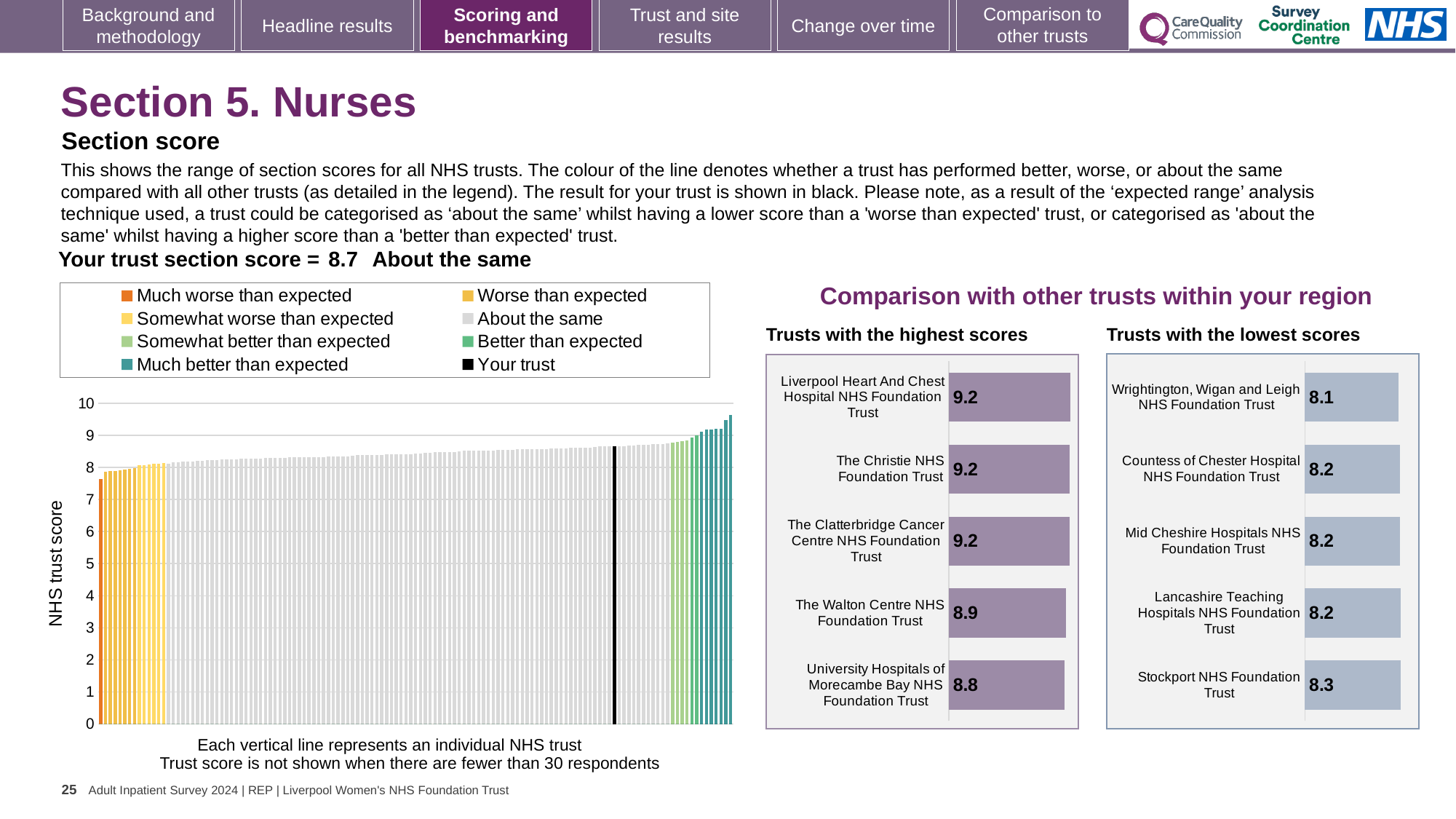
On the large chart on the left showing NHS trust scores, what kind of chart is it? Bar chart On the 'Trusts with the highest scores' chart, how many trusts are shown? 5 On the 'Trusts with the lowest scores' chart, which has the larger score: Stockport NHS Foundation Trust or Wrightington, Wigan and Leigh NHS Foundation Trust? Stockport NHS Foundation Trust On the large chart on the left showing NHS trust scores, do the values rise or fall from left to right? Rise On the 'Trusts with the highest scores' chart, what is the difference between the score for Liverpool Heart And Chest Hospital NHS Foundation Trust and the score for University Hospitals of Morecambe Bay NHS Foundation Trust? 0.4 On the 'Trusts with the lowest scores' chart, what is the difference between the score for Stockport NHS Foundation Trust and the score for Wrightington, Wigan and Leigh NHS Foundation Trust? 0.2 On the large chart on the left showing NHS trust scores, how many entries does the legend list? 8 On the 'Trusts with the highest scores' chart, which trust has the lowest score? University Hospitals of Morecambe Bay NHS Foundation Trust On the 'Trusts with the highest scores' chart, what is the score for The Walton Centre NHS Foundation Trust? 8.9 On the 'Trusts with the lowest scores' chart, what is the score for Wrightington, Wigan and Leigh NHS Foundation Trust? 8.1 On the 'Trusts with the highest scores' chart, what is the score for University Hospitals of Morecambe Bay NHS Foundation Trust? 8.8 On the 'Trusts with the lowest scores' chart, which trust has the highest score? Stockport NHS Foundation Trust